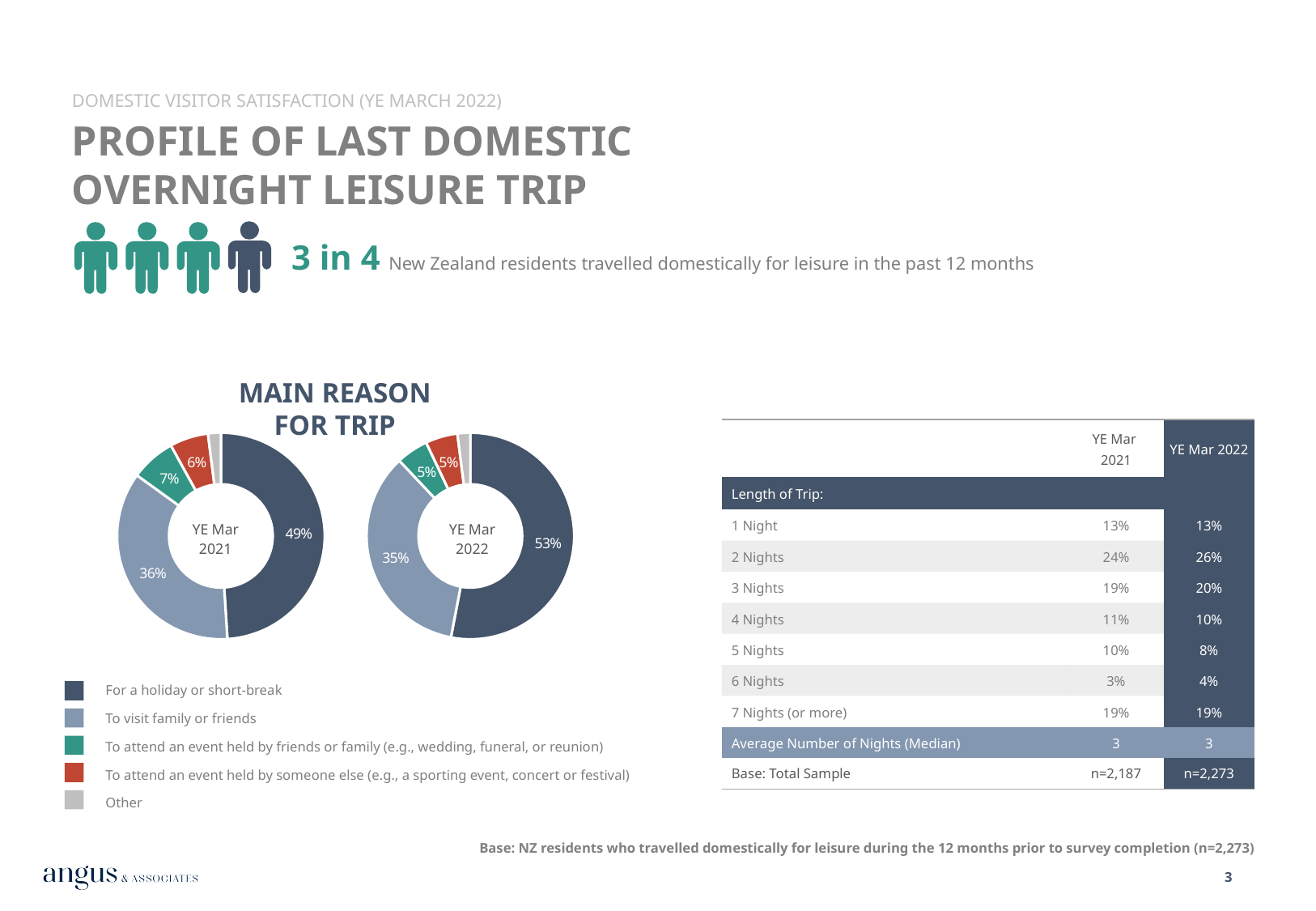
In the YE Mar 2022 donut chart, which reason for trip has the largest share? For a holiday or short-break In the YE Mar 2021 donut chart, what share of trips were for a holiday or short-break? 49% In the YE Mar 2021 donut chart, which labelled reason for trip has the smallest share? To attend an event held by someone else In the YE Mar 2021 donut chart, what share of trips were to attend an event held by friends or family? 7% In the Main Reason for Trip charts, which colour represents 'To visit family or friends'? Light blue-grey Is the share for visiting family or friends larger in the YE Mar 2021 chart or the YE Mar 2022 chart? YE Mar 2021 In the YE Mar 2022 donut chart, what share of trips were to attend an event held by someone else? 5% In the YE Mar 2022 donut chart, what share of trips were to visit family or friends? 35% How many donut charts are shown under the Main Reason for Trip title? 2 What type of chart is used to show the main reason for trip? Donut (pie) chart How many categories does the legend for the Main Reason for Trip charts list? 5 What is the difference between the holiday or short-break share in YE Mar 2022 and in YE Mar 2021? 4 percentage points